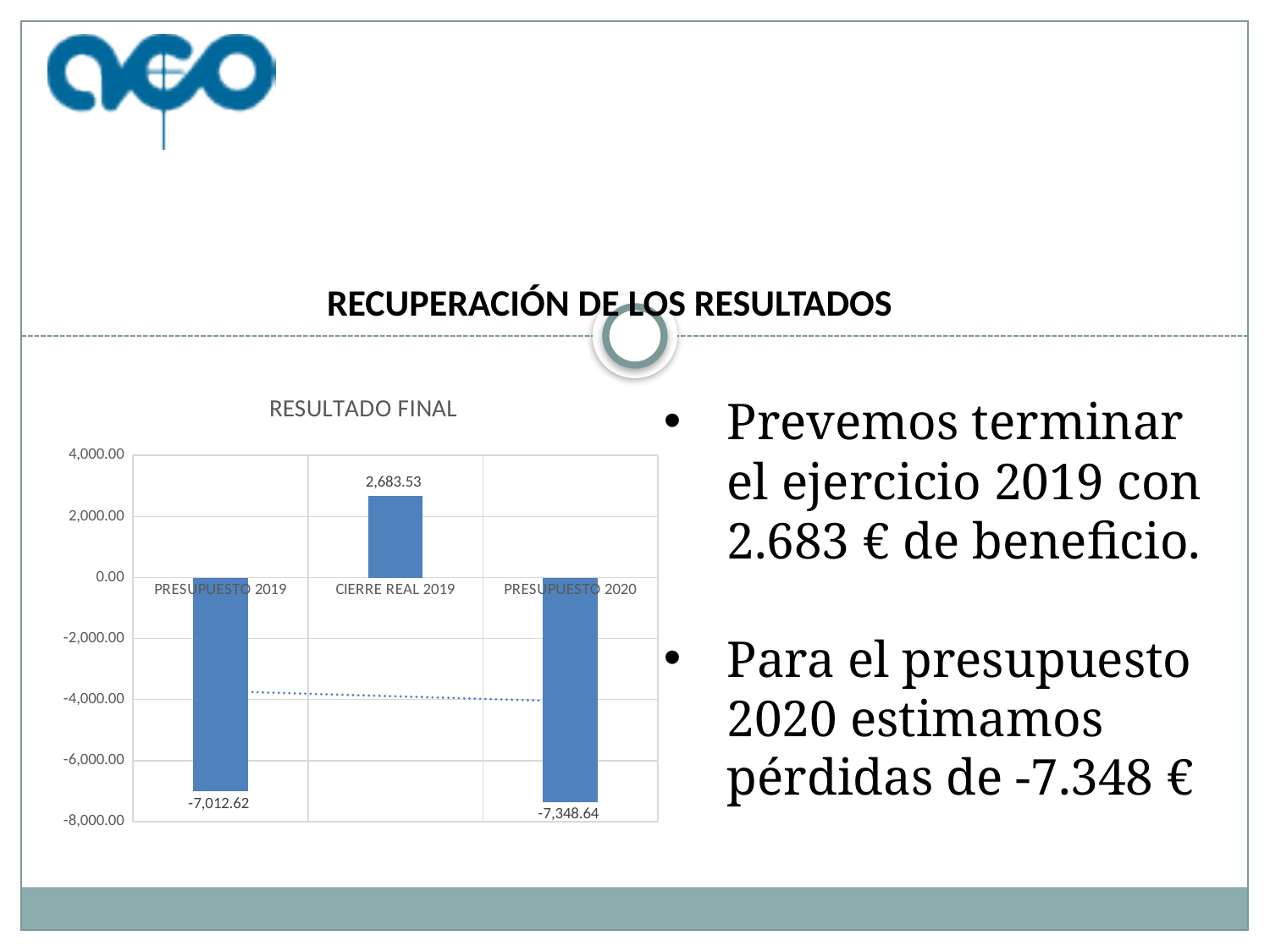
What is the difference between the values for CIERRE REAL 2019 and PRESUPUESTO 2019 in the RESULTADO FINAL chart? 9,696.15 What is the title of the chart on the slide? RESULTADO FINAL Which is larger in the RESULTADO FINAL chart, the value for PRESUPUESTO 2019 or PRESUPUESTO 2020? PRESUPUESTO 2019 Is the value for CIERRE REAL 2019 in the RESULTADO FINAL chart greater or less than 2,000.00? greater What is the value for PRESUPUESTO 2019 in the RESULTADO FINAL chart? -7,012.62 How many categories are shown in the RESULTADO FINAL chart? 3 What is the difference between the values for PRESUPUESTO 2019 and PRESUPUESTO 2020 in the RESULTADO FINAL chart? 336.02 What is the value for PRESUPUESTO 2020 in the RESULTADO FINAL chart? -7,348.64 What is the value for CIERRE REAL 2019 in the RESULTADO FINAL chart? 2,683.53 Which category has the lowest value in the RESULTADO FINAL chart? PRESUPUESTO 2020 What kind of chart is the RESULTADO FINAL chart? bar chart Which category has the highest value in the RESULTADO FINAL chart? CIERRE REAL 2019